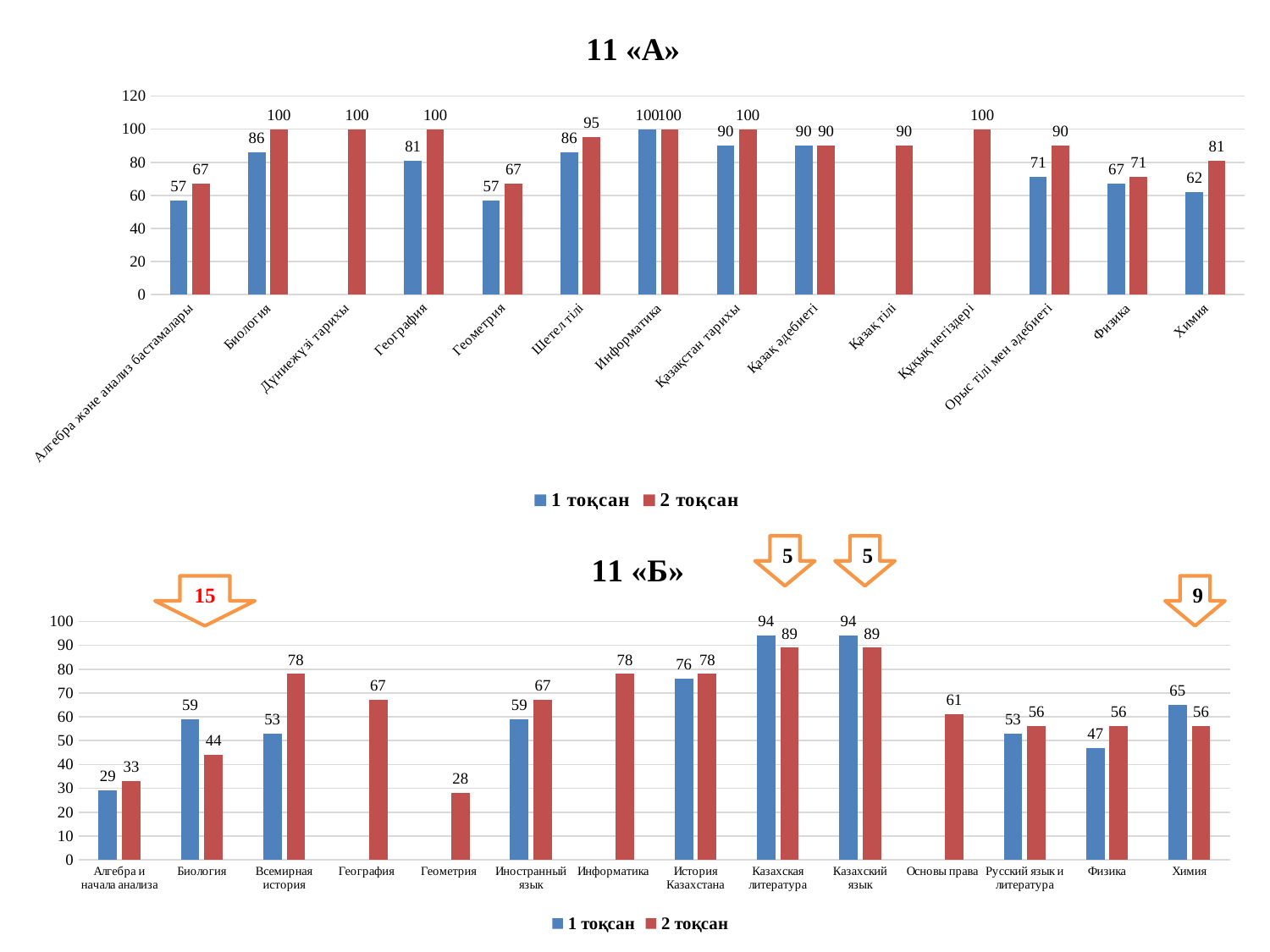
In the 11 «А» chart, how many categories are shown on the x axis? 14 In the 11 «А» chart, what is the 1 тоқсан value for Орыс тілі мен әдебиеті? 71 In the 11 «Б» chart, what is the highest 2 тоқсан value? 89 In the 11 «А» chart, what is the value for Химия in the 2 тоқсан series? 81 In the 11 «А» chart, which category has the lowest 1 тоқсан value? Алгебра және анализ бастамалары and Геометрия (both 57) What type of chart is the 11 «А» chart? Bar chart How many series does the legend of the 11 «Б» chart list? 2 In the 11 «Б» chart, what is the 2 тоқсан value for Геометрия? 28 In the 11 «А» chart, what is the difference between the 2 тоқсан and 1 тоқсан values for Биология? 14 In the 11 «Б» chart, what is the difference between the 1 тоқсан and 2 тоқсан values for Всемирная история? 25 In the 11 «Б» chart, which category has the lowest 1 тоқсан value? Алгебра и начала анализа In the 11 «Б» chart, which is larger for Биология: the 1 тоқсан value or the 2 тоқсан value? 1 тоқсан